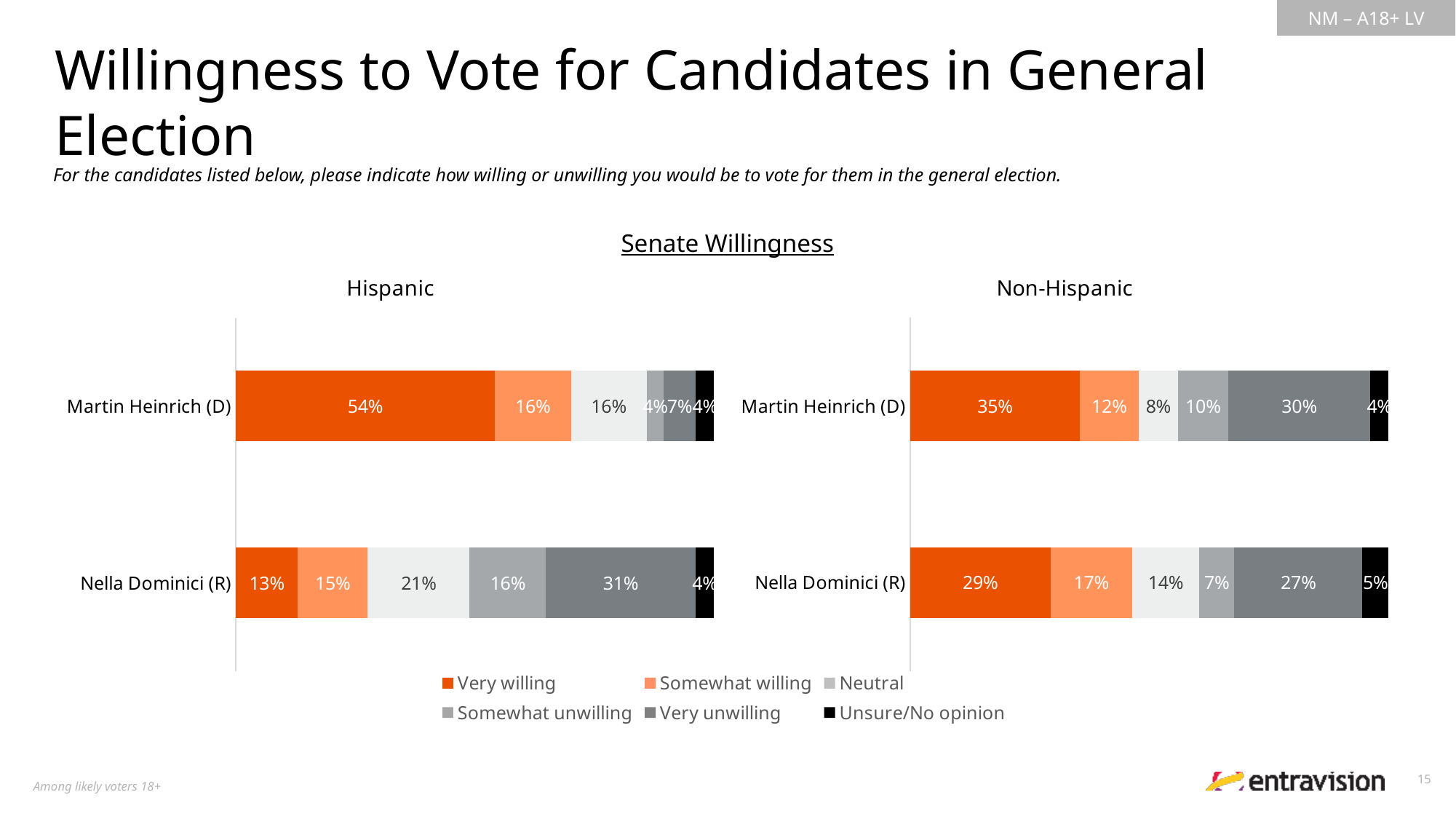
In the Hispanic chart, what percentage of respondents are very willing to vote for Martin Heinrich (D)? 54% In the Non-Hispanic chart, what is the difference between the very willing percentages for Martin Heinrich (D) and Nella Dominici (R)? 6% In the Hispanic chart, what percentage are very unwilling to vote for Nella Dominici (R)? 31% Is the very willing percentage for Martin Heinrich (D) higher in the Hispanic chart or the Non-Hispanic chart? Hispanic What type of chart is used to show Senate Willingness? Stacked bar chart In the Hispanic chart, which candidate has the higher very willing percentage? Martin Heinrich (D) In the Non-Hispanic chart, which candidate has the lower somewhat unwilling percentage? Nella Dominici (R) In the Non-Hispanic chart, what percentage are very unwilling to vote for Martin Heinrich (D)? 30% In the Hispanic chart, what is the difference between the very willing percentages for Martin Heinrich (D) and Nella Dominici (R)? 41% How many candidates are shown in the Hispanic chart? 2 In the Non-Hispanic chart, what percentage are neutral about voting for Nella Dominici (R)? 14% How many series does the legend list? 6